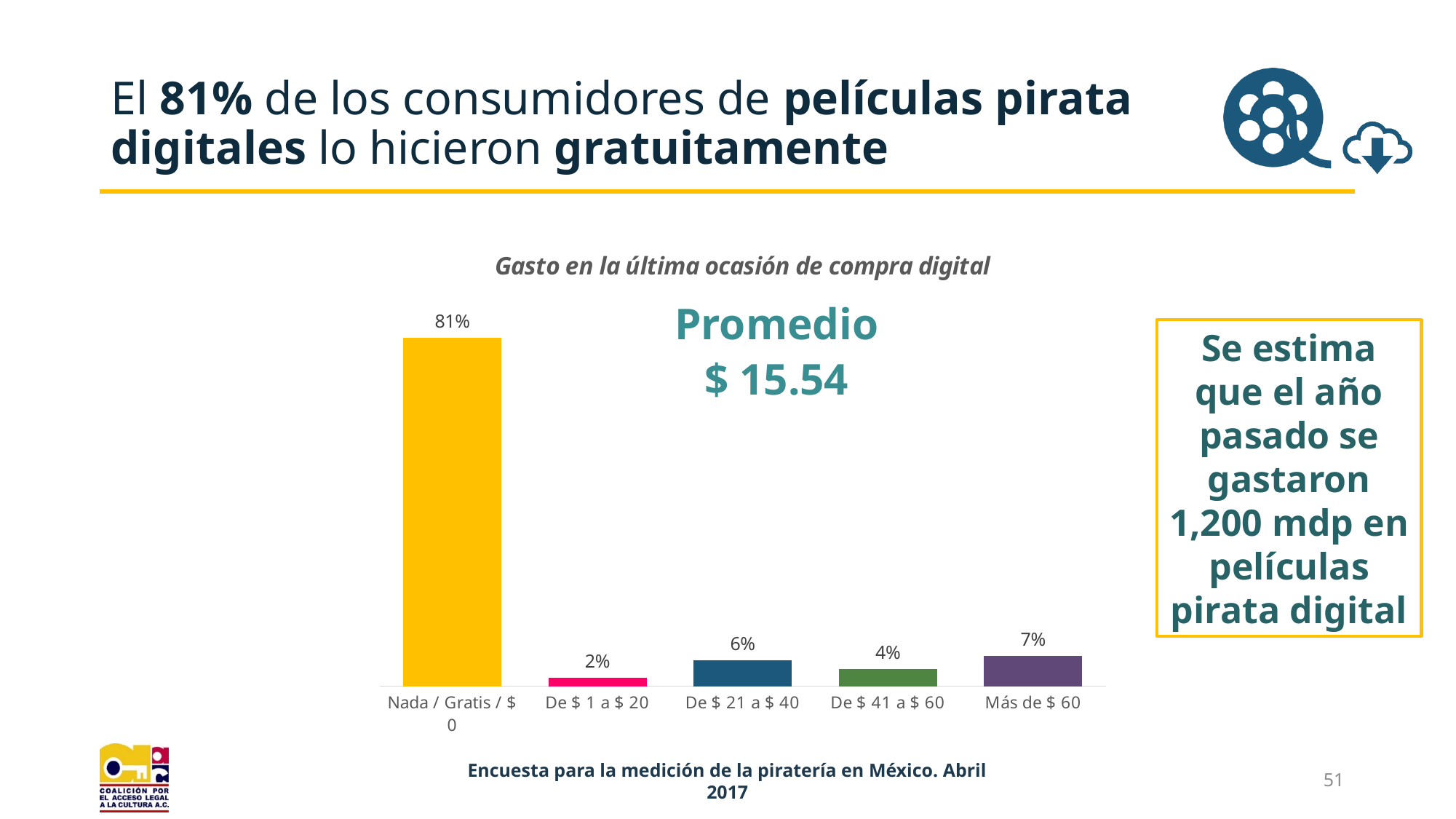
What kind of chart is shown on the slide? Bar chart What is the title of the chart? Gasto en la última ocasión de compra digital Which category has the lowest value? De $ 1 a $ 20 Which category has the highest value? Nada / Gratis / $ 0 What percentage is shown for the 'Nada / Gratis / $ 0' category? 81% What average (Promedio) value is printed on the chart? $ 15.54 What percentage is shown for the 'De $ 21 a $ 40' category? 6% What is the difference between the values for 'Nada / Gratis / $ 0' and 'Más de $ 60'? 74% What percentage is shown for the 'De $ 41 a $ 60' category? 4% How many categories are shown on the x axis of the chart? 5 What percentage is shown for the 'Más de $ 60' category? 7% Which is larger, the value for 'De $ 21 a $ 40' or the value for 'De $ 41 a $ 60'? De $ 21 a $ 40